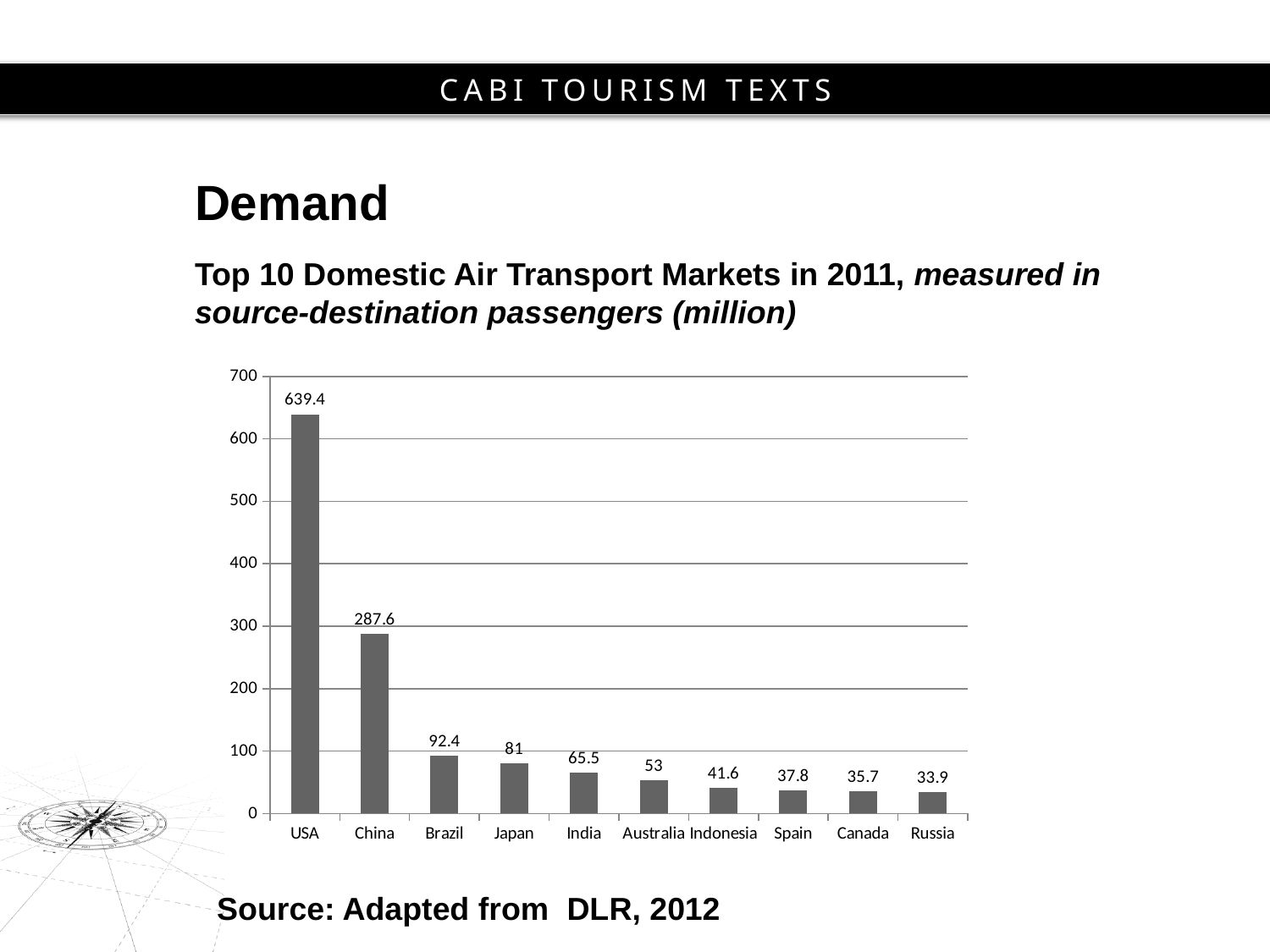
What is the value for Indonesia? 41.6 What kind of chart is shown on the slide? bar chart What is the difference between the values for Brazil and Japan? 11.4 Which country has the lowest value? Russia Which has a larger value, India or Australia? India What is the value for the USA? 639.4 What is the difference between the values for the USA and China? 351.8 What is the value for China? 287.6 Do the values rise or fall from left to right along the x axis? fall How many countries are shown on the chart? 10 Which country has the highest value? USA Is the value for Brazil greater or less than 100? less